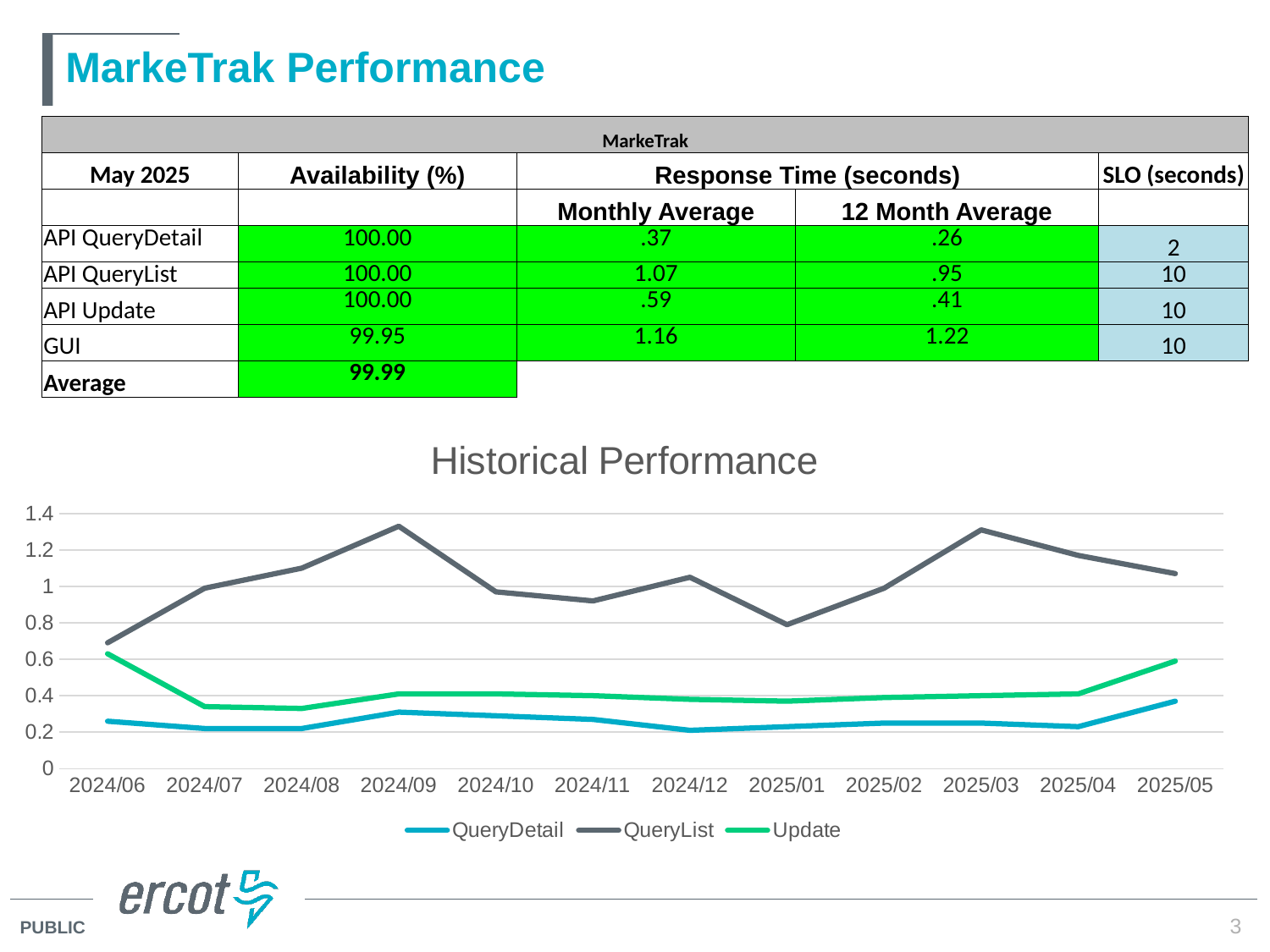
How many series does the legend of the Historical Performance chart list? 3 In the Historical Performance chart, is the QueryList value for 2024/09 greater or less than 1.2? greater In the Historical Performance chart, is the QueryList value for 2024/06 greater or less than 0.8? less Which series in the Historical Performance chart has the lowest values across the whole period? QueryDetail What is the title of the line chart on the slide? Historical Performance In the Historical Performance chart, which is larger at 2024/09: QueryList or Update? QueryList Which series in the Historical Performance chart has the highest values across the whole period? QueryList In the Historical Performance chart, is the Update value for 2025/05 greater or less than 0.4? greater In the Historical Performance chart, does the QueryDetail line rise or fall from 2025/04 to 2025/05? rise In the Historical Performance chart, does the QueryList line rise or fall from 2024/06 to 2024/09? rise What kind of chart is the Historical Performance chart? line chart How many months are plotted along the x axis of the Historical Performance chart? 12